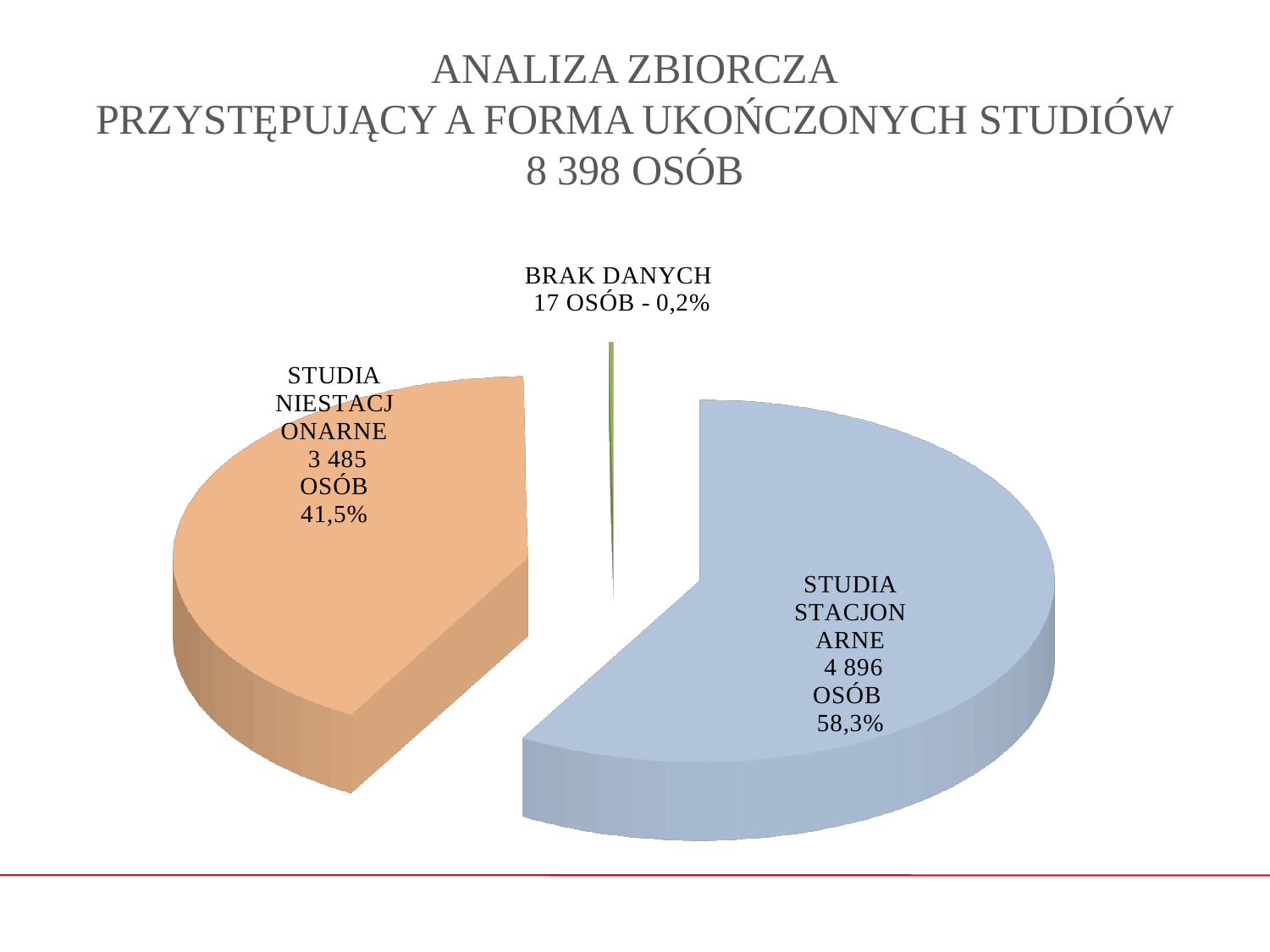
What kind of chart is shown on the slide? pie chart What share of the pie does STUDIA STACJONARNE represent? 58,3% What share of the pie does STUDIA NIESTACJONARNE represent? 41,5% What total number of people is stated in the chart title? 8 398 OSÓB What is the difference in number of people between STUDIA STACJONARNE and STUDIA NIESTACJONARNE? 1 411 What share of the pie does BRAK DANYCH represent? 0,2% Which slice is the smallest? BRAK DANYCH How many people are in the STUDIA STACJONARNE slice? 4 896 How many people are in the STUDIA NIESTACJONARNE slice? 3 485 Which slice is the largest? STUDIA STACJONARNE How many slices does the pie chart have? 3 How many people are in the BRAK DANYCH slice? 17